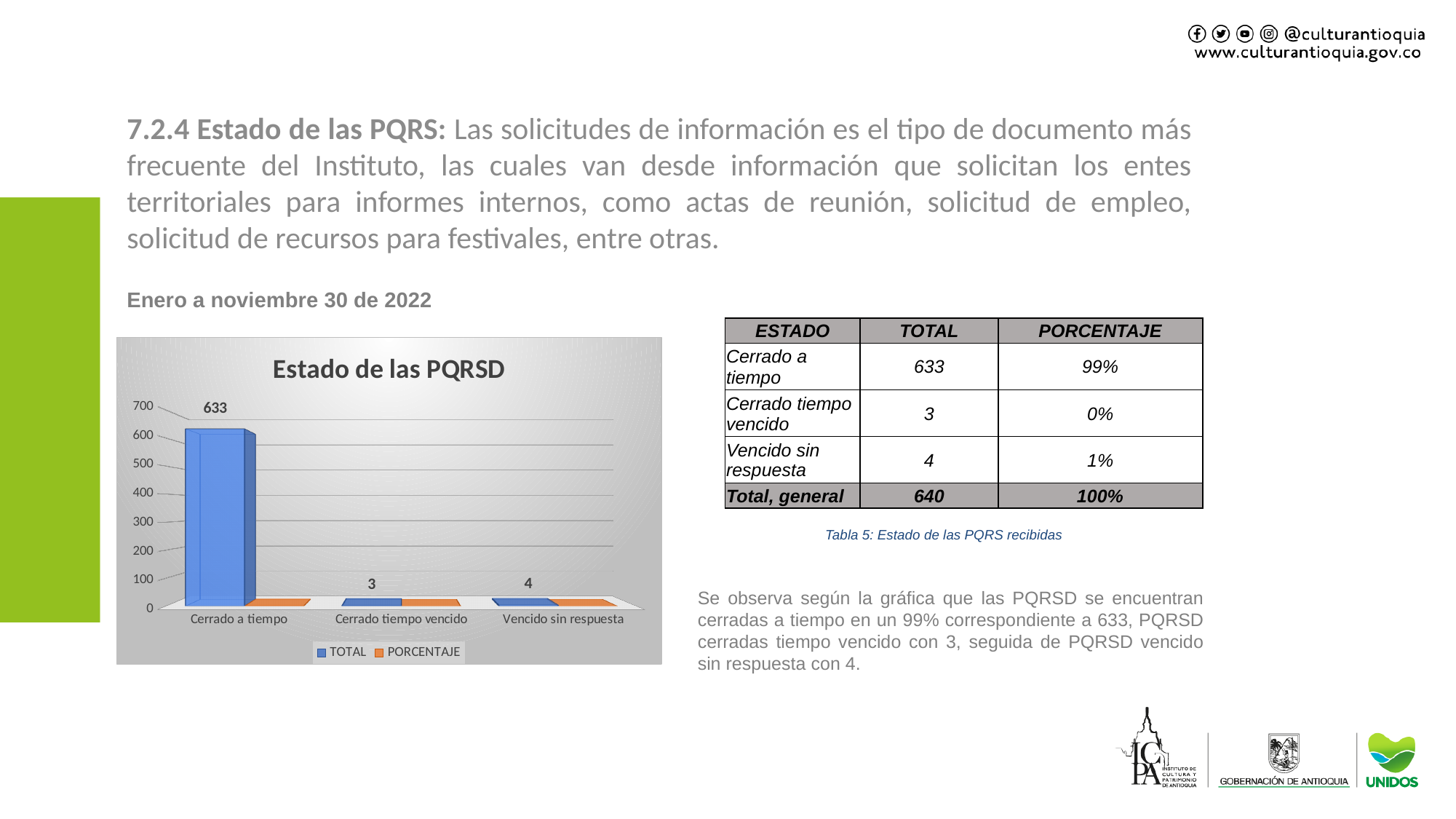
How many categories are shown on the x axis of the chart? 3 Which category has the highest TOTAL value in the chart? Cerrado a tiempo What is the TOTAL value for Vencido sin respuesta in the chart? 4 Which is larger, the TOTAL for Vencido sin respuesta or the TOTAL for Cerrado tiempo vencido? Vencido sin respuesta Which category has the lowest TOTAL value in the chart? Cerrado tiempo vencido What type of chart is shown on the slide? bar chart Is the TOTAL value for Cerrado a tiempo greater or less than 600? greater What is the TOTAL value for Cerrado a tiempo in the chart? 633 What is the title of the chart? Estado de las PQRSD How many series does the chart legend list? 2 What is the TOTAL value for Cerrado tiempo vencido in the chart? 3 What is the difference between the TOTAL for Cerrado a tiempo and the TOTAL for Vencido sin respuesta? 629